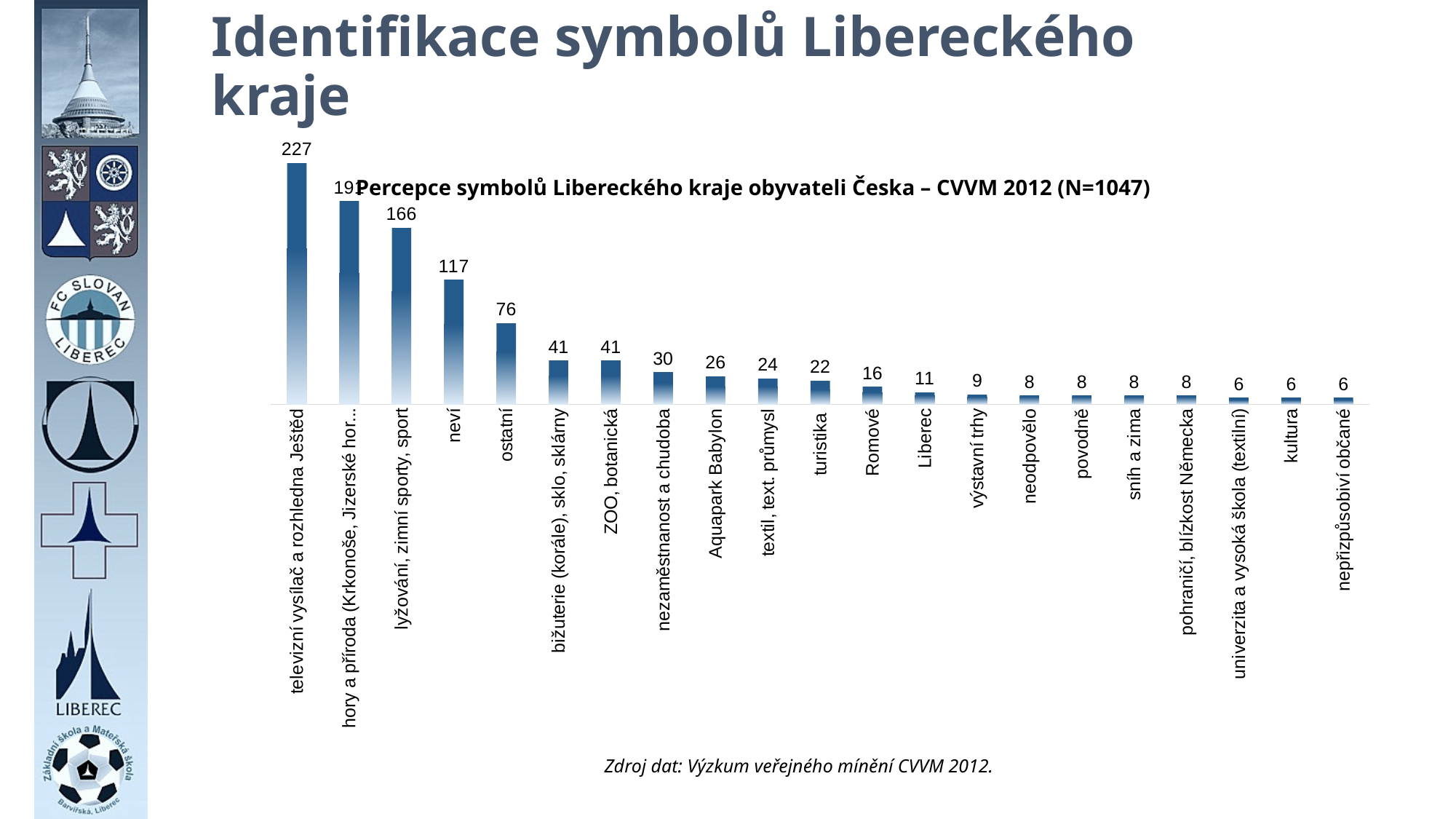
Which category has the highest value? televizní vysílač a rozhledna Ještěd What is the value for 'lyžování, zimní sporty, sport'? 166 What is the title of the chart? Percepce symbolů Libereckého kraje obyvateli Česka – CVVM 2012 (N=1047) What is the difference between the values for 'ostatní' and 'neví'? 41 What kind of chart is shown on the slide? bar chart Which is larger, the value for 'textil, text. průmysl' or the value for 'Liberec'? textil, text. průmysl What is the value for 'televizní vysílač a rozhledna Ještěd'? 227 How many categories are shown in the chart? 21 What is the value for 'neví'? 117 What is the value for 'Romové'? 16 What is the difference between the values for 'nezaměstnanost a chudoba' and 'turistika'? 8 What is the value for 'Aquapark Babylon'? 26